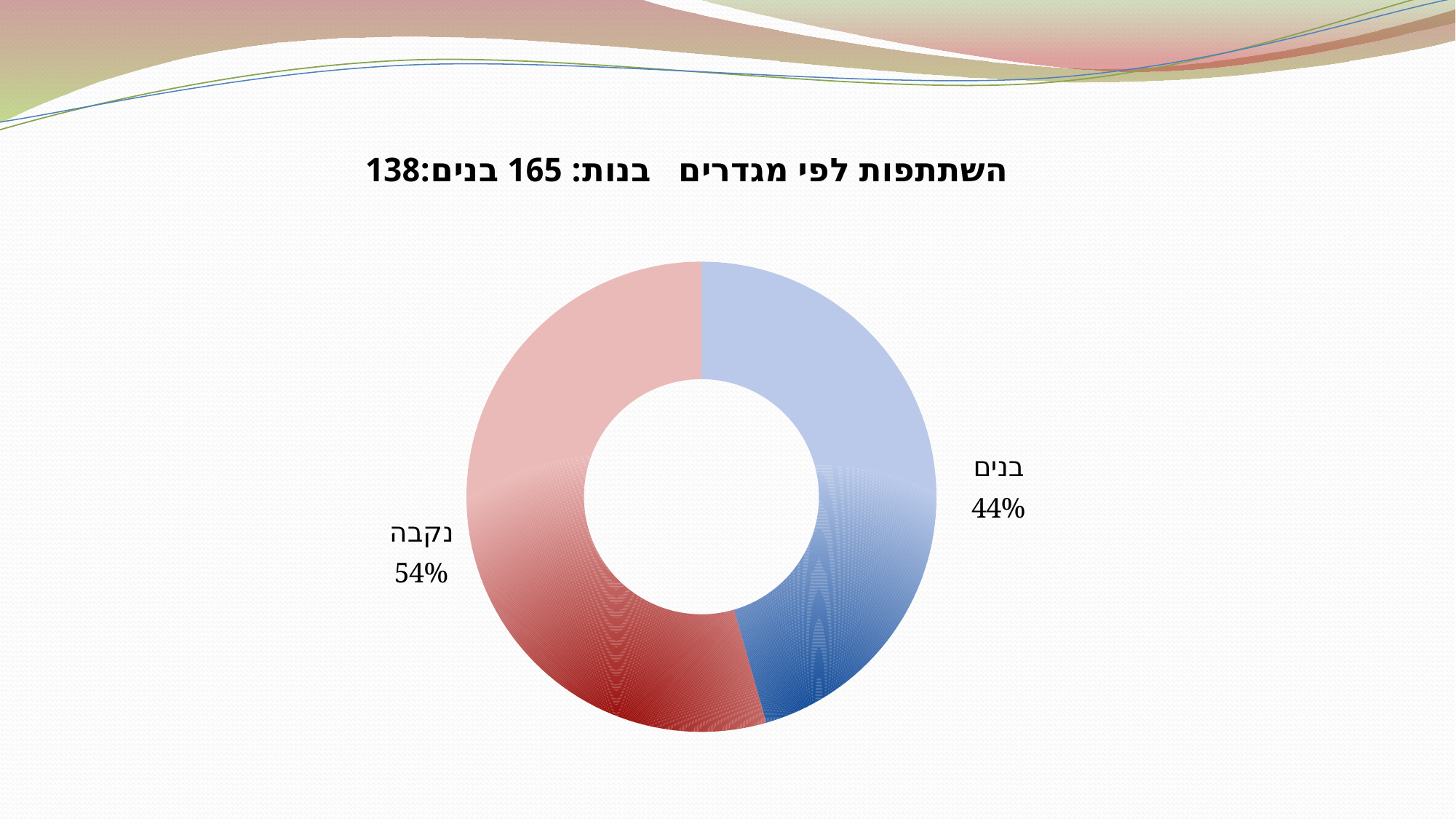
How many slices does the chart have? 2 Which slice has the larger share, נקבה or בנים? נקבה What percentage is shown for the נקבה slice? 54% According to the slide title, how many בנות participated? 165 What percentage is shown for the בנים slice? 44% Which category has the smallest share in the chart? בנים What colour is the בנים slice? blue What is the difference in percentage points between the נקבה slice and the בנים slice? 10 What kind of chart is shown on the slide? doughnut chart Which category has the largest share in the chart? נקבה